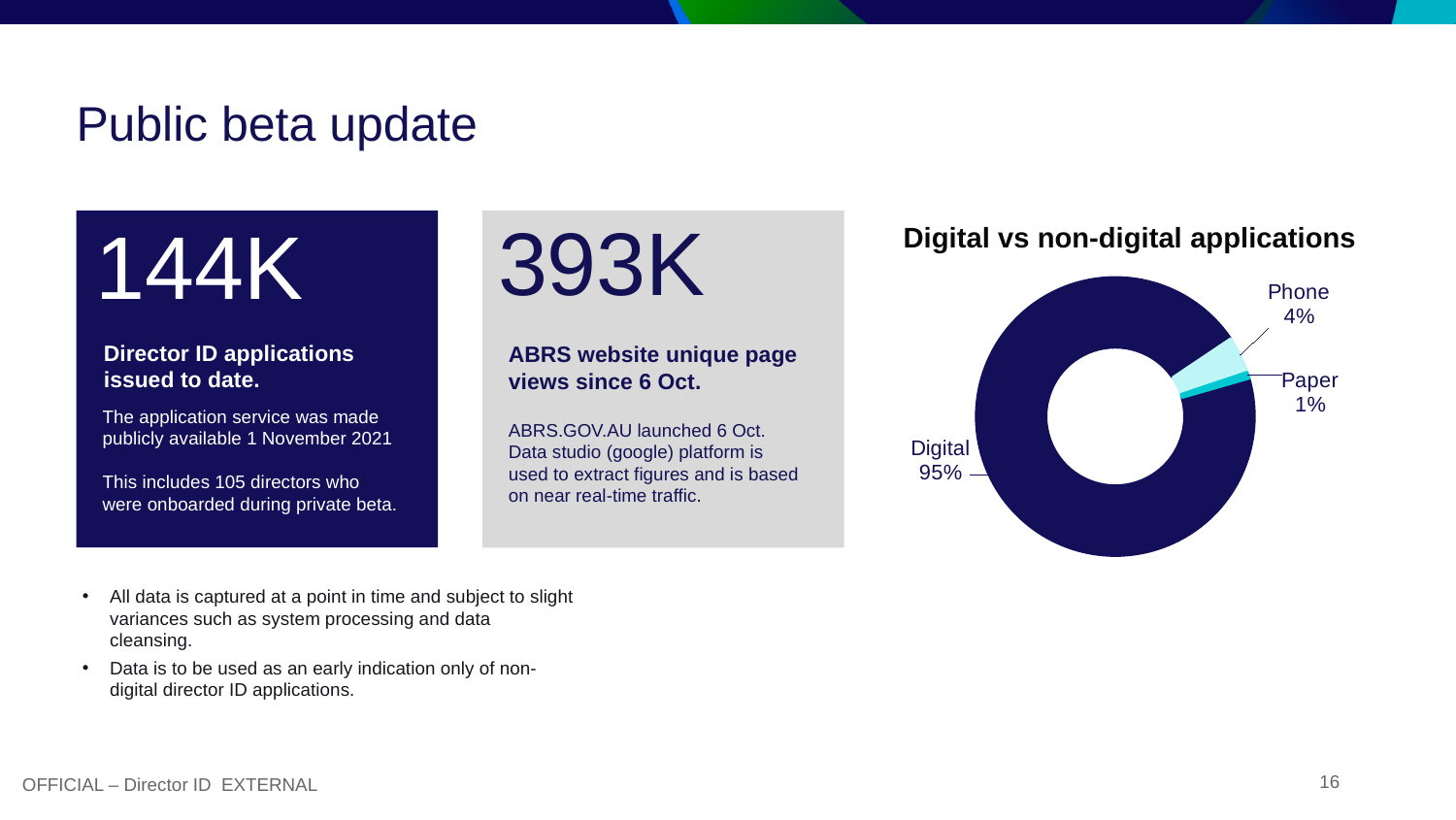
Which is larger, the Phone share or the Paper share? Phone What share of applications is Digital? 95% Which category has the smallest share of applications? Paper What is the difference in percentage points between the Digital and Phone shares? 91 What share of applications is Paper? 1% How many categories are shown in the chart? 3 What is the combined share of the non-digital (Phone and Paper) applications? 5% Which category has the largest share of applications? Digital What is the difference in percentage points between the Phone and Paper shares? 3 What share of applications is Phone? 4% What is the title of the chart on the slide? Digital vs non-digital applications What kind of chart is shown on the slide? Doughnut (pie) chart